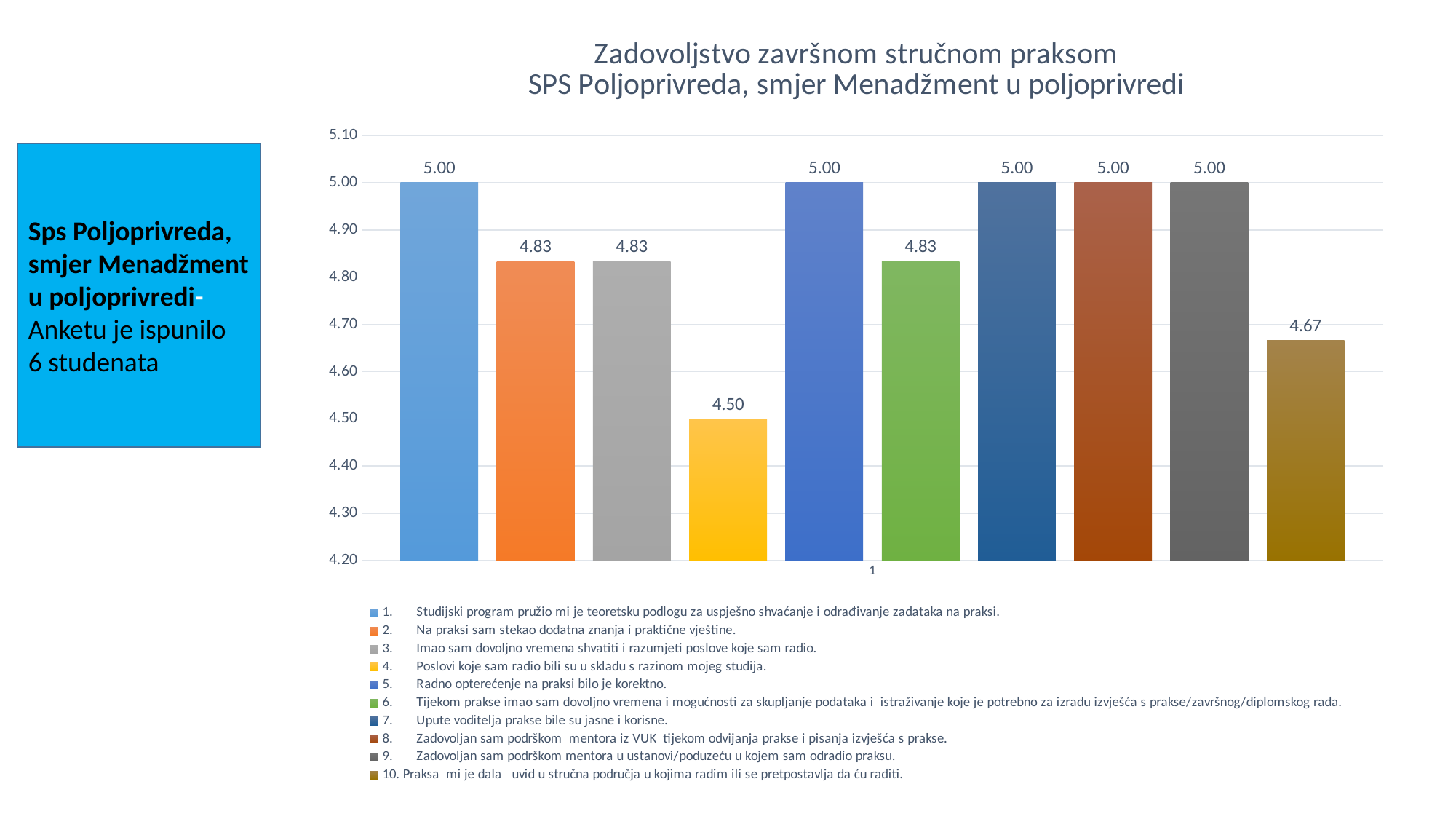
What is the value for series 10, "Praksa mi je dala uvid u stručna područja u kojima radim ili se pretpostavlja da ću raditi."? 4.67 What is the difference between the value for series 3 and the value for series 10? 0.16 What is the value for series 2, "Na praksi sam stekao dodatna znanja i praktične vještine."? 4.83 What is the value for series 7, "Upute voditelja prakse bile su jasne i korisne."? 5.00 Is the value for series 10 greater or less than 4.70? less How many series does the legend list? 10 Which series has the lowest value? 4. Poslovi koje sam radio bili su u skladu s razinom mojeg studija. What is the value for series 4, "Poslovi koje sam radio bili su u skladu s razinom mojeg studija."? 4.50 What kind of chart is shown on the slide? Bar chart How many series have a value of 5.00? 5 Which is larger, the value for series 6 or the value for series 10? Series 6 What is the difference between the value for series 1 and the value for series 4? 0.50